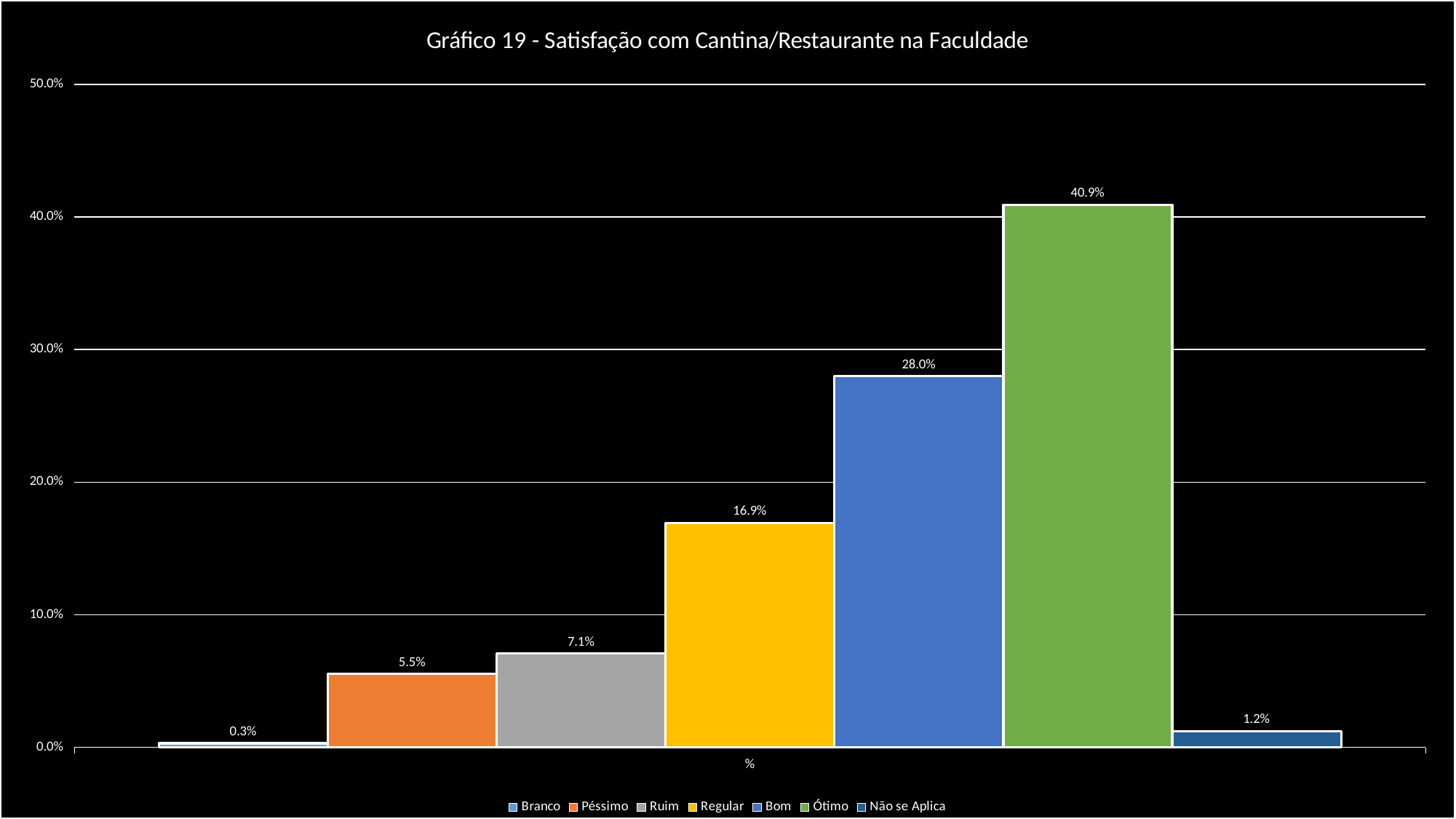
Which is larger, the value for Bom or the value for Regular? Bom Which category has the highest value? Ótimo What is the value for Não se Aplica? 1.2% What is the title of the chart? Gráfico 19 - Satisfação com Cantina/Restaurante na Faculdade What kind of chart is shown? bar chart What is the value for Ótimo? 40.9% What is the difference between the values for Ruim and Péssimo? 1.6% What is the value for Regular? 16.9% Is the value for Bom greater or less than 30.0%? less How many series does the legend list? 7 Which category has the lowest value? Branco What is the difference between the values for Ótimo and Bom? 12.9%